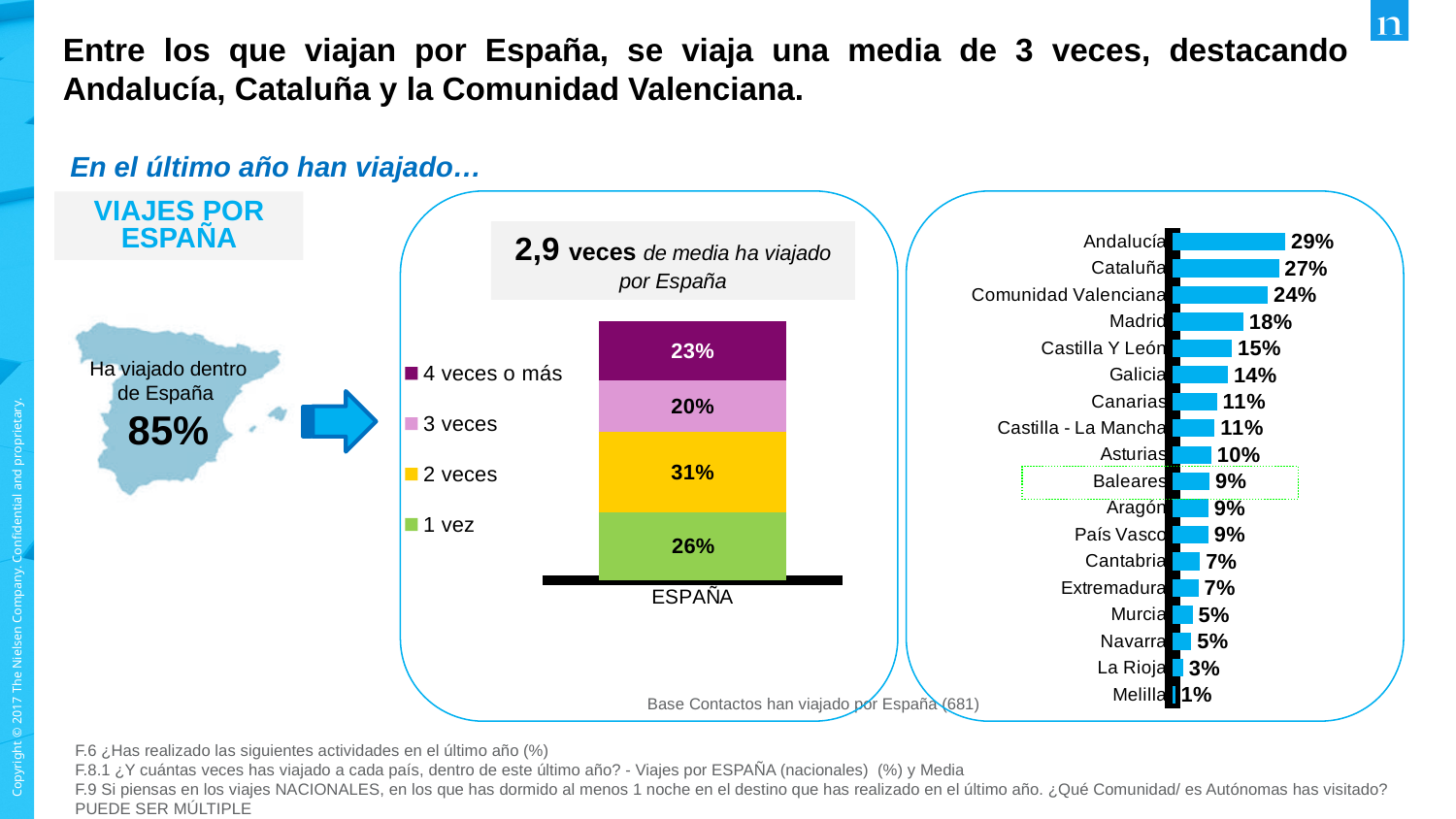
In the horizontal bar chart of regions on the right, which region has the lowest value? Melilla In the stacked bar chart labelled ESPAÑA, what is the value for the '4 veces o más' segment? 23% In the horizontal bar chart of regions on the right, what is the difference between Cataluña and Madrid? 9% In the horizontal bar chart of regions on the right, which is larger, Canarias or Cantabria? Canarias What kind of chart is the chart of regions on the right of the slide? Bar chart In the stacked bar chart labelled ESPAÑA, what is the value for the '2 veces' segment? 31% In the horizontal bar chart of regions on the right, what is the value for Galicia? 14% How many regions are shown in the horizontal bar chart on the right? 18 In the horizontal bar chart of regions on the right, what is the value for Andalucía? 29% In the stacked bar chart labelled ESPAÑA, what is the total of all segments in the bar? 100% How many series does the legend of the stacked bar chart labelled ESPAÑA list? 4 In the horizontal bar chart of regions on the right, which region has the highest value? Andalucía